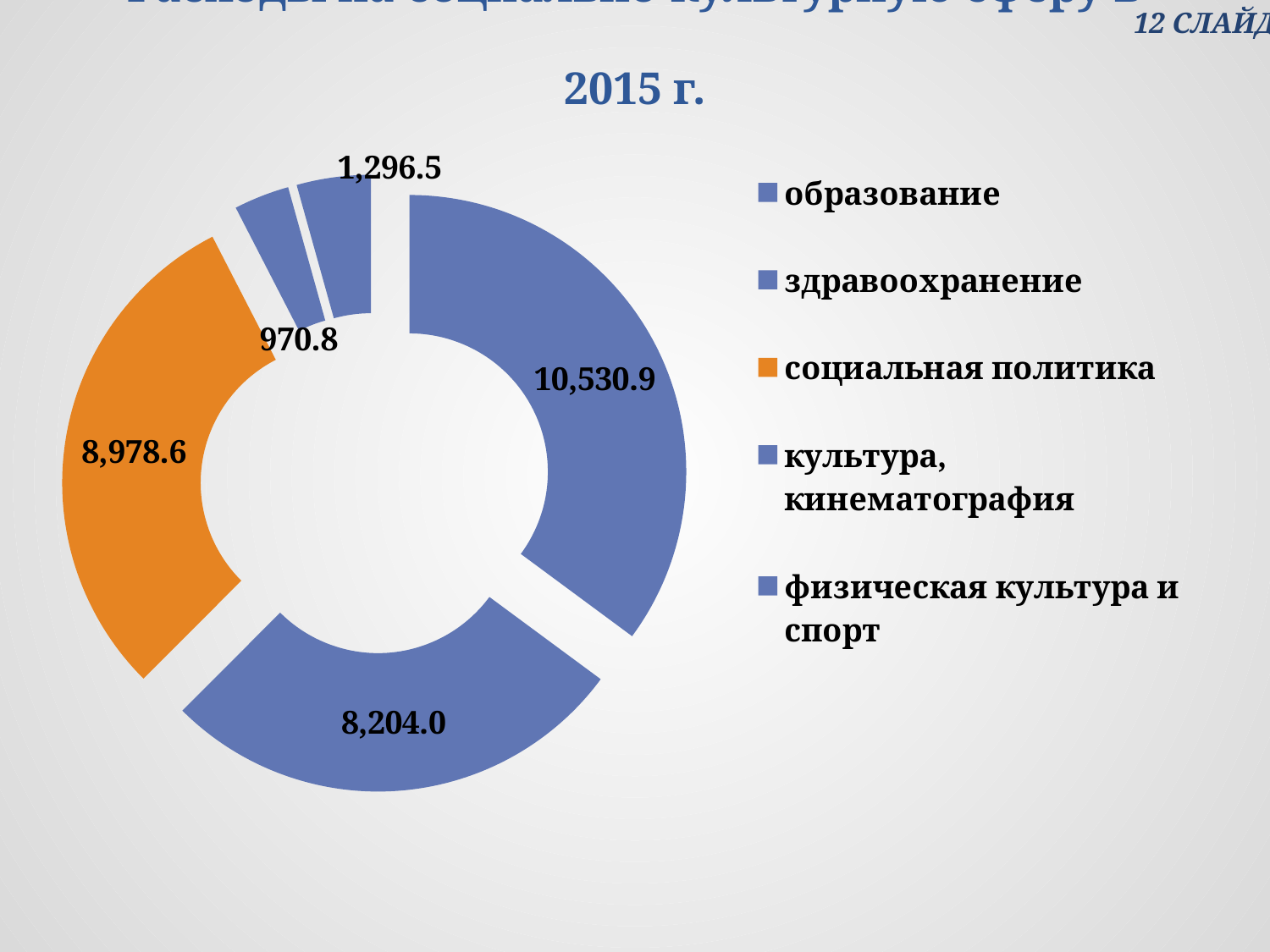
What is the difference between the values for социальная политика and здравоохранение? 774.6 Which category has the smallest value? культура, кинематография Which category has the largest value? образование What is the value for образование? 10,530.9 What year is shown in the chart title? 2015 г. How many categories does the legend list? 5 What is the difference between the values for образование and социальная политика? 1,552.3 Which category is shown in orange? социальная политика What is the value for социальная политика? 8,978.6 What type of chart is shown on the slide? Doughnut (pie) chart Which is larger, the value for социальная политика or the value for здравоохранение? социальная политика What is the value for здравоохранение? 8,204.0